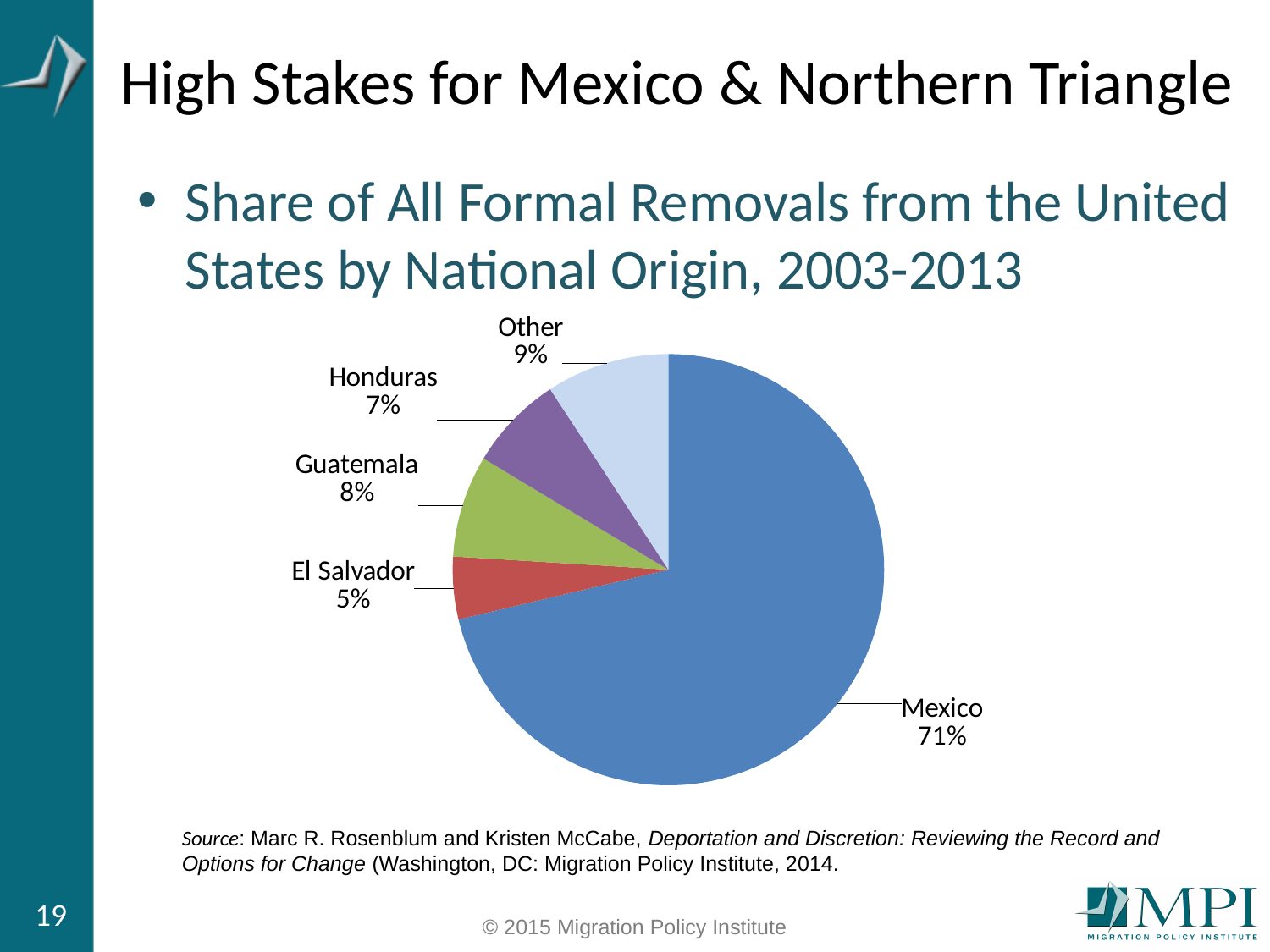
What share of formal removals does Mexico account for? 71% What is the difference in percentage points between Mexico's share and Guatemala's share? 63 What share of formal removals does Guatemala account for? 8% Which national origin has the largest share of formal removals? Mexico What share of formal removals is labelled Other? 9% What is the combined share of Guatemala, Honduras and El Salvador? 20% How many slices does the pie chart have? 5 What kind of chart is shown on the slide? pie chart Which has a larger share of formal removals, Honduras or Guatemala? Guatemala Which national origin has the smallest share of formal removals? El Salvador What share of formal removals does Honduras account for? 7% What share of formal removals does El Salvador account for? 5%